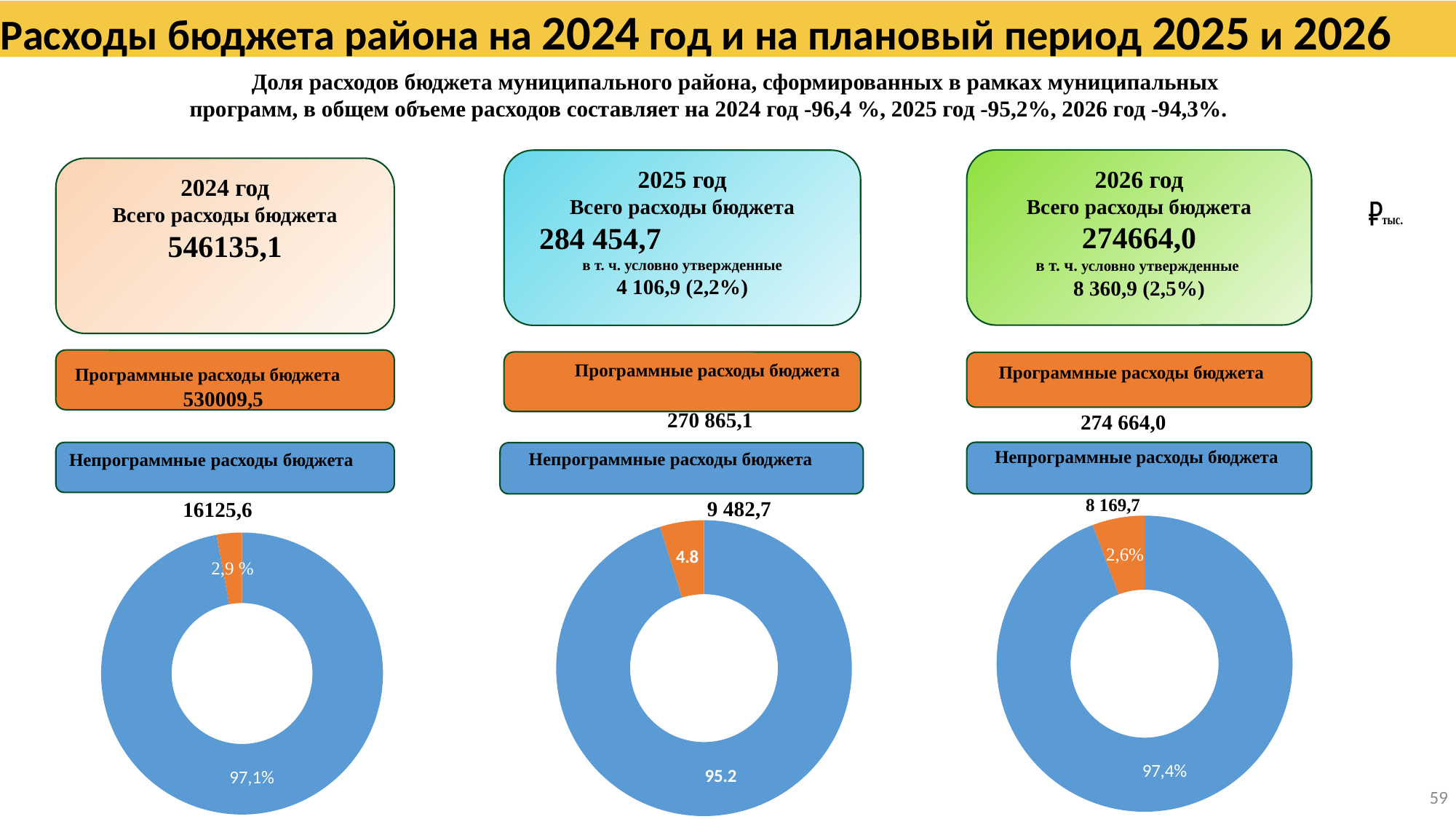
How many donut charts are shown on the slide? 3 What kind of chart is shown under the 2024 column on the left of the slide? Donut (pie) chart In the middle donut chart (2025), what value is printed on the blue slice? 95.2 How many slices does the left donut chart (2024) have? 2 In the left donut chart (2024), what value is printed on the large blue slice? 97,1% In the left donut chart (2024), what value is printed on the small orange slice? 2,9 % In the right donut chart (2026), which slice is larger, the blue one or the orange one? Blue In the middle donut chart (2025), what value is printed on the orange slice? 4.8 In the right donut chart (2026), what value is printed on the blue slice? 97,4% In the right donut chart (2026), what value is printed on the orange slice? 2,6%